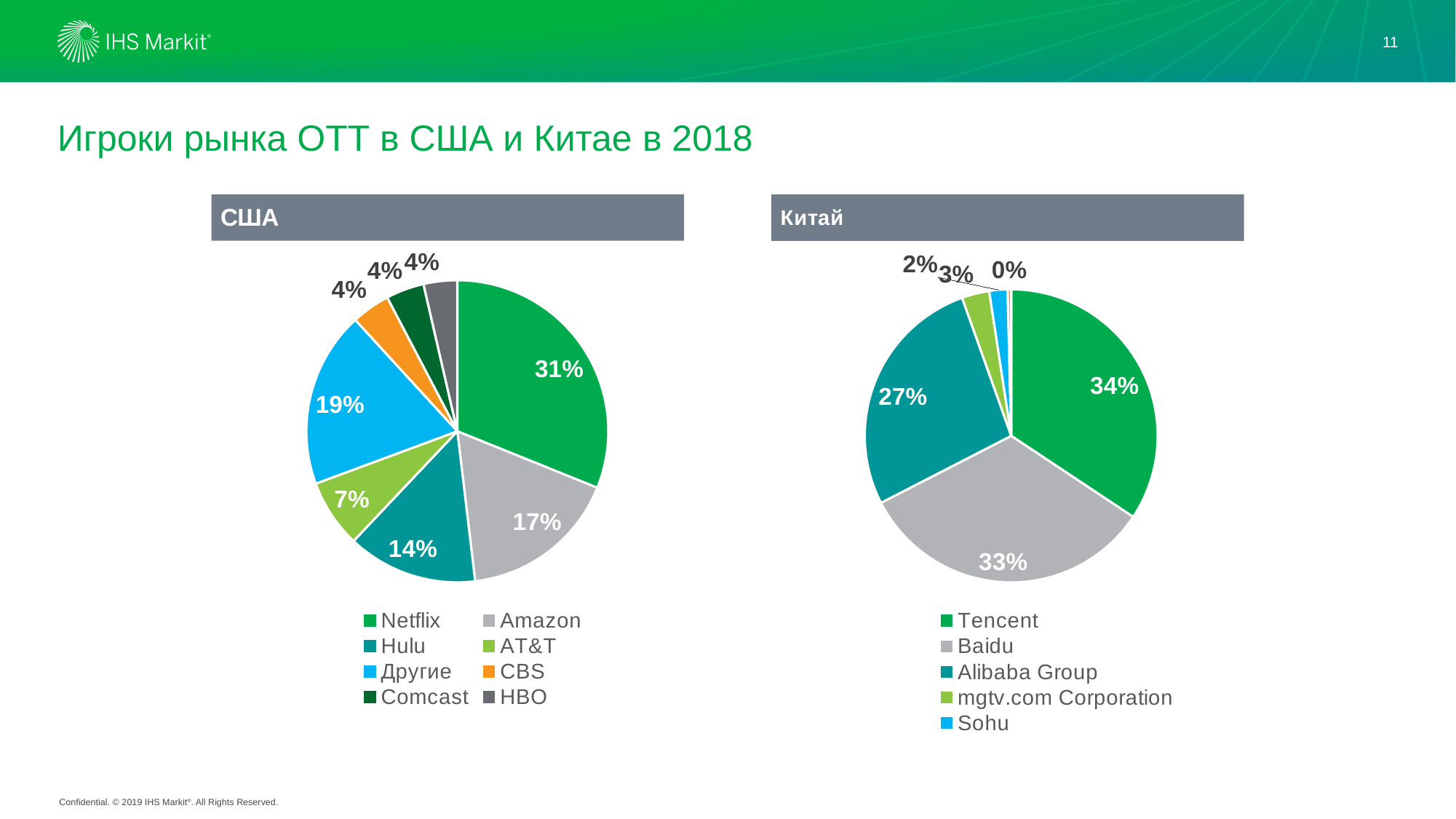
In the США pie chart, which company has the largest share? Netflix In the Китай pie chart, what share does Alibaba Group hold? 27% In the Китай pie chart, what share does Tencent hold? 34% In the США pie chart, what share does Netflix hold? 31% In the США pie chart, which is larger, the Amazon share or the AT&T share? Amazon What type of chart is used for the Китай data? Pie chart In the США pie chart, what share does Amazon hold? 17% In the США pie chart, what share is labelled Другие? 19% In the США pie chart, what is the difference between the Netflix share and the Hulu share? 17% How many entries does the legend of the Китай chart list? 5 In the Китай pie chart, what is the difference between the Baidu share and the Alibaba Group share? 6% How many entries does the legend of the США chart list? 8